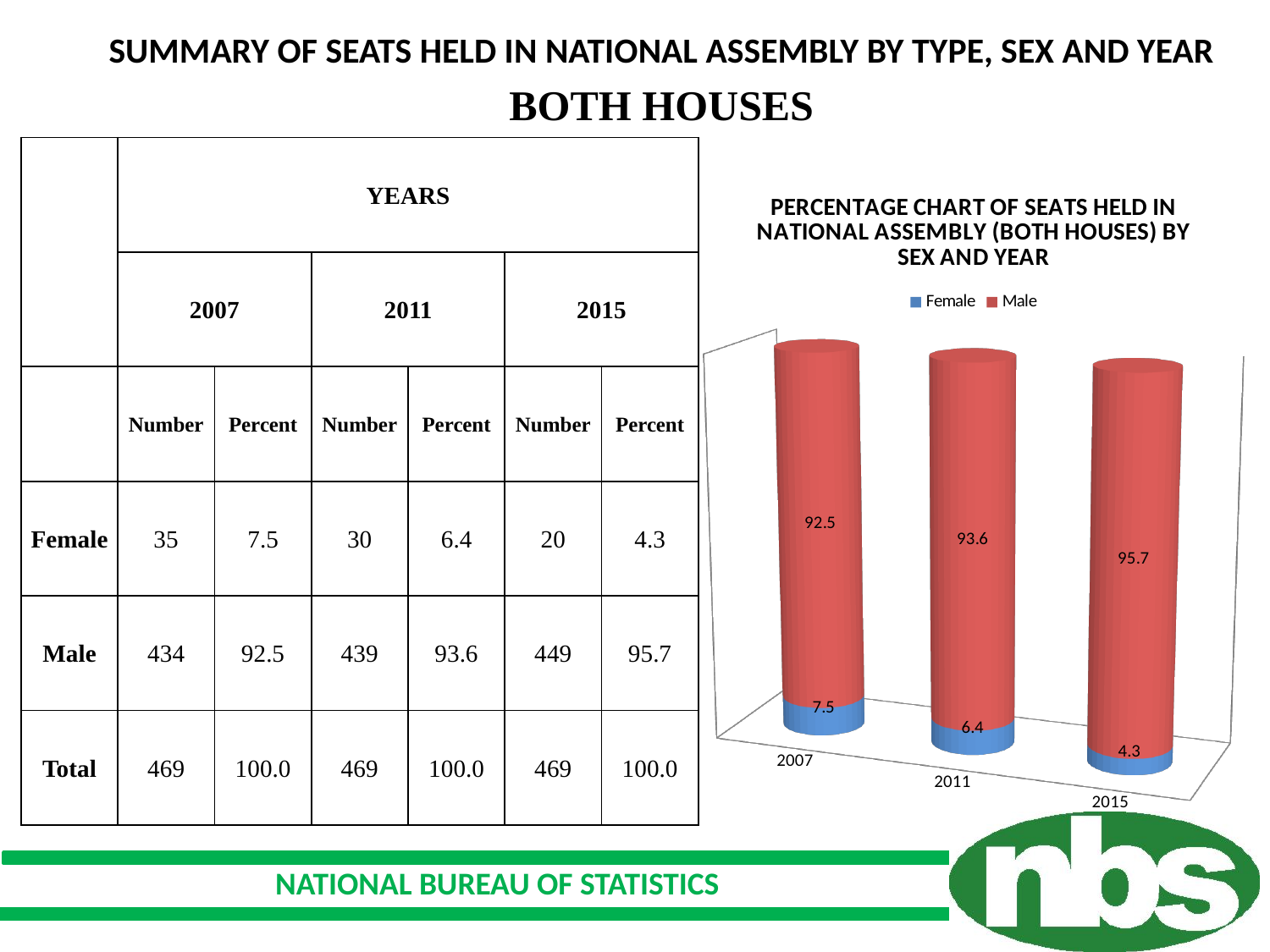
How many years are shown on the x axis of the chart? 3 What is the Male value for 2015 in the chart? 95.7 Does the Female value rise or fall from 2007 to 2015 in the chart? Fall What is the Female value for 2015 in the chart? 4.3 What is the Male value for 2011 in the chart? 93.6 What is the difference between the Male values for 2015 and 2007 in the chart? 3.2 What kind of chart is shown on the slide? Stacked bar chart How many series does the chart's legend list? 2 In which year is the Female value lowest in the chart? 2015 In which year is the Male value highest in the chart? 2015 What is the Female value for 2007 in the chart? 7.5 Which is larger in the chart: the Female value for 2007 or the Female value for 2011? 2007